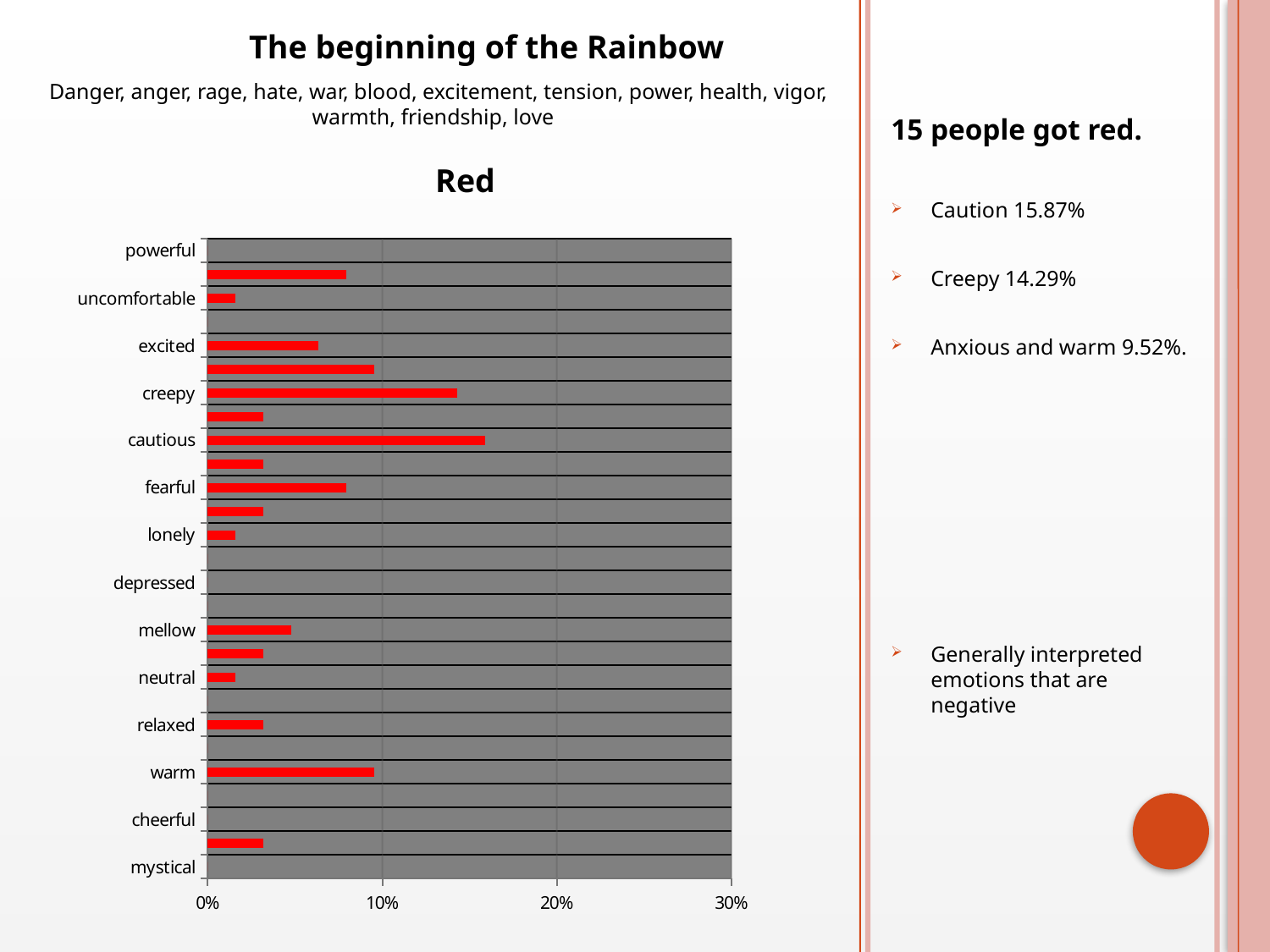
Which has the larger value, fearful or lonely? fearful What kind of chart is shown on the slide? bar chart Which has the larger value, excited or neutral? excited What is the title of the chart? Red Which labelled category has the longest bar in the chart? cautious Is the value for cautious greater or less than 10%? greater Which has the larger value, creepy or warm? creepy Is the value for cautious greater or less than 20%? less What is the highest value shown on the x axis of the chart? 30% Is the value for creepy greater or less than 10%? greater